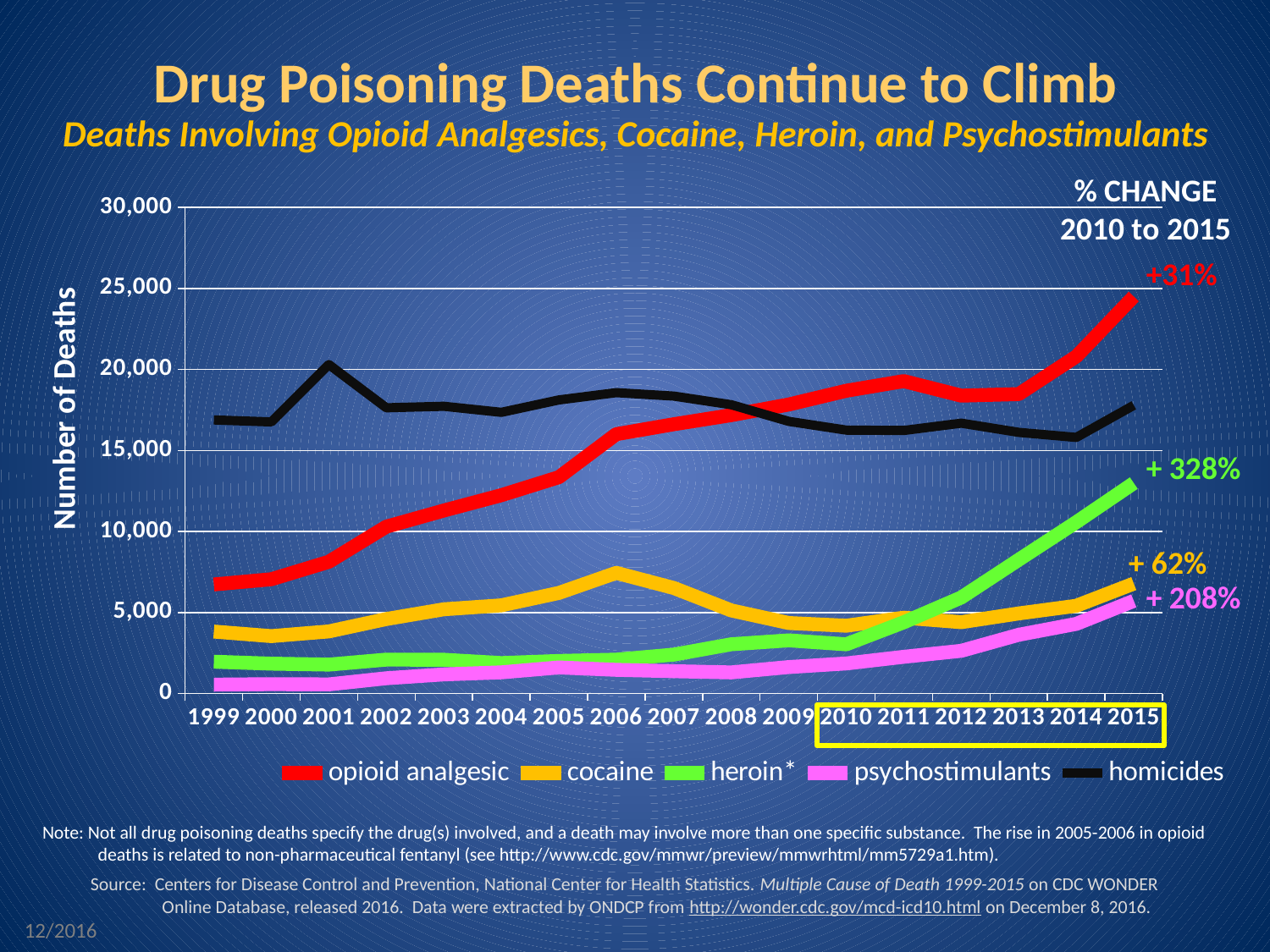
Which series has the lowest number of deaths in 1999? psychostimulants How many series does the legend list? 5 Do opioid analgesic deaths generally rise or fall from 1999 to 2015? rise In 2015, which is larger: heroin deaths or cocaine deaths? heroin What is the percent change from 2010 to 2015 shown for heroin? + 328% What kind of chart is shown on the slide? line chart What is the percent change from 2010 to 2015 shown for opioid analgesic deaths? +31% What colour is the line for homicides? black Is the value for opioid analgesic deaths in 2015 greater or less than 20,000? greater Which series has the highest number of deaths in 2015? opioid analgesic How many years are plotted along the x axis? 17 What is the percent change from 2010 to 2015 shown for psychostimulants? + 208%